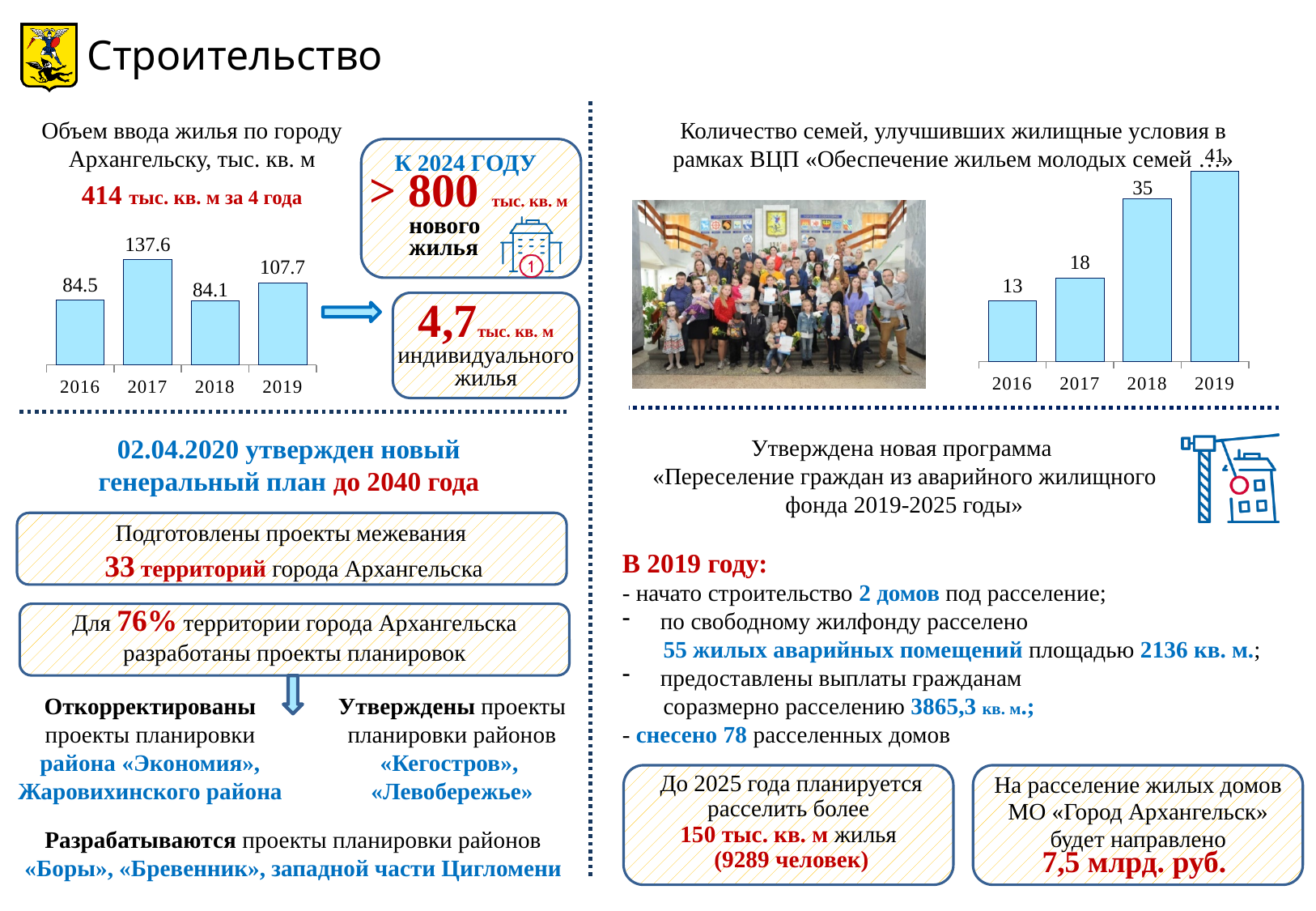
In the left chart (Объем ввода жилья по городу Архангельску), what is the value for 2019? 107.7 In the right chart (Количество семей, улучшивших жилищные условия), do the values rise or fall from 2016 to 2019? rise In the left chart (Объем ввода жилья по городу Архангельску), how many years are shown? 4 In the left chart (Объем ввода жилья по городу Архангельску), what is the difference between the 2017 and 2019 values? 29.9 In the left chart (Объем ввода жилья по городу Архангельску), which year has the highest value? 2017 In the right chart (Количество семей, улучшивших жилищные условия), which is larger, the value for 2017 or the value for 2018? 2018 In the left chart (Объем ввода жилья по городу Архангельску), what is the value for 2017? 137.6 In the right chart (Количество семей, улучшивших жилищные условия), what is the value for 2018? 35 In the right chart (Количество семей, улучшивших жилищные условия), which year has the highest value? 2019 In the right chart (Количество семей, улучшивших жилищные условия), what is the difference between the 2019 and 2016 values? 28 In the left chart (Объем ввода жилья по городу Архангельску), which year has the lowest value? 2018 What type of chart is the left chart (Объем ввода жилья по городу Архангельску)? bar chart